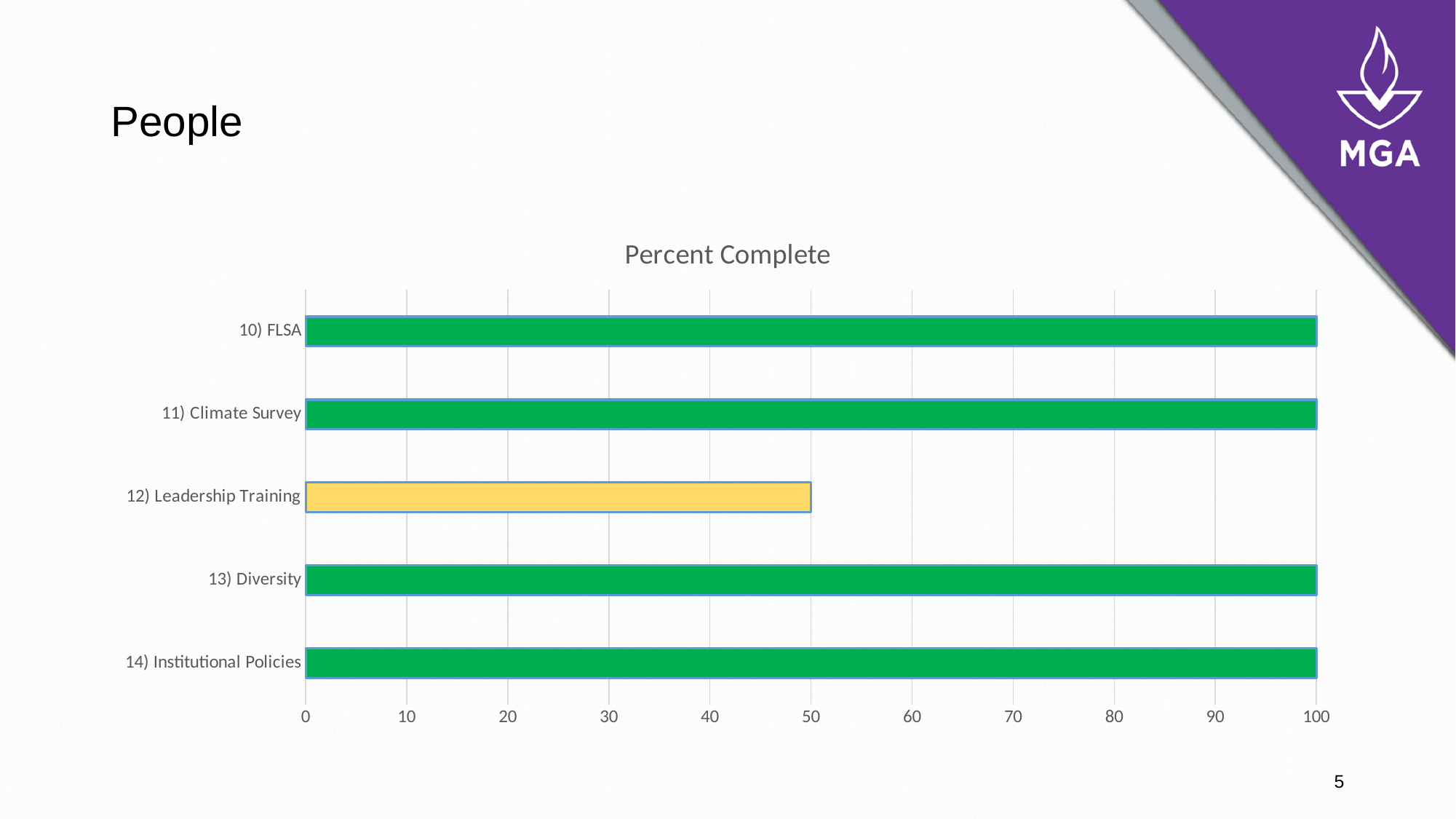
What colour is the bar for 12) Leadership Training? yellow Which is larger, the value for 14) Institutional Policies or the value for 12) Leadership Training? 14) Institutional Policies How many categories are plotted in the chart? 5 What is the difference between the values for 11) Climate Survey and 12) Leadership Training? 50 What kind of chart is shown on the slide? bar chart Which category has the lowest value? 12) Leadership Training What is the value for 13) Diversity? 100 What is the value for 12) Leadership Training? 50 How many categories have a value of 100? 4 Is the value for 12) Leadership Training greater or less than 80? less What is the value for 10) FLSA? 100 What is the title of the chart? Percent Complete